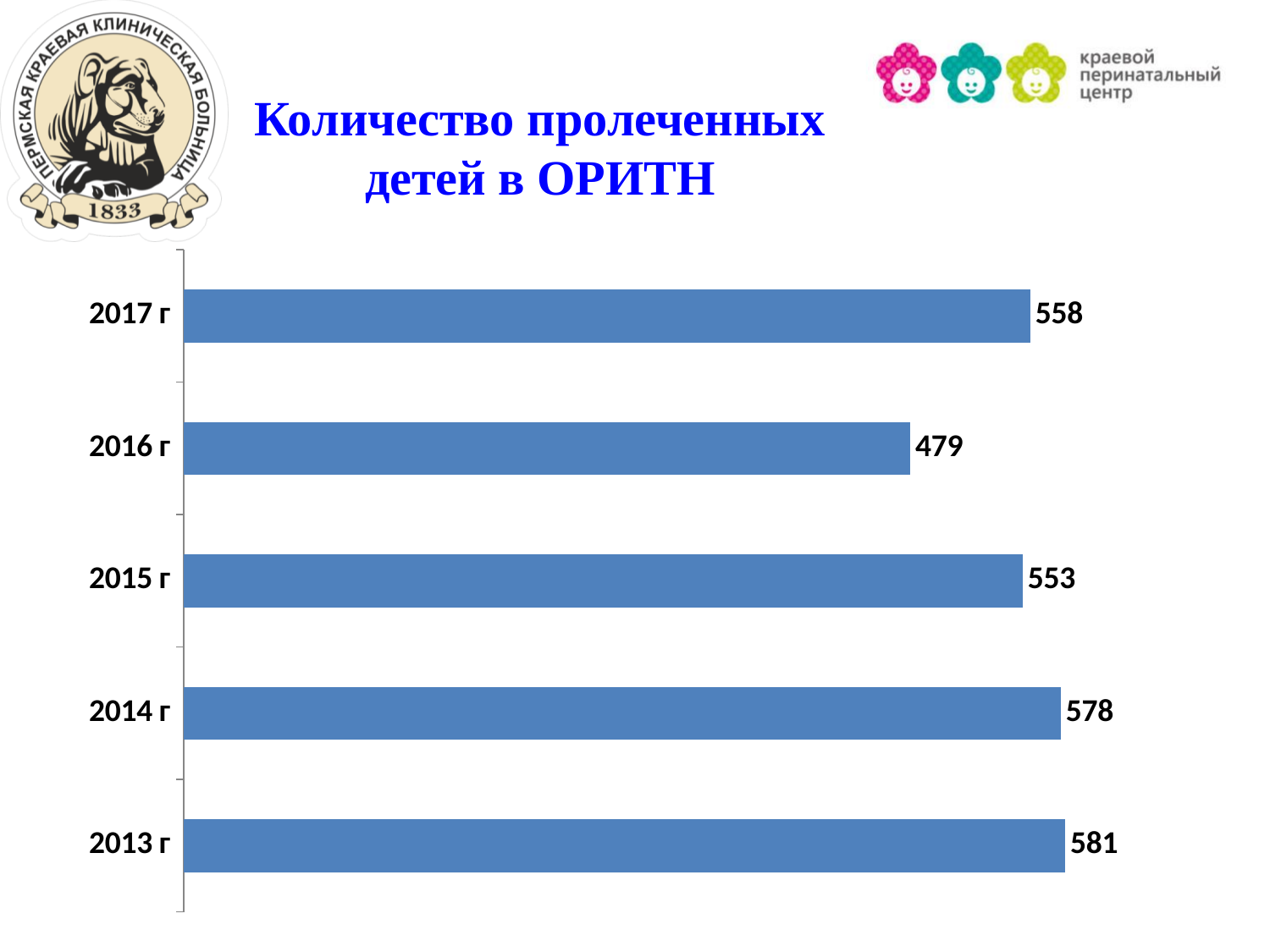
How many years are shown in the chart? 5 What is the value for 2013 г? 581 What is the value for 2017 г? 558 What is the title of the chart on the slide? Количество пролеченных детей в ОРИТН What is the difference between the values for 2013 г and 2014 г? 3 Which year has the highest value? 2013 г Which year has the lowest value? 2016 г Which is larger, the value for 2015 г or the value for 2016 г? 2015 г What is the difference between the values for 2017 г and 2016 г? 79 What kind of chart is shown on the slide? bar chart What colour are the bars in the chart? blue What is the value for 2016 г? 479